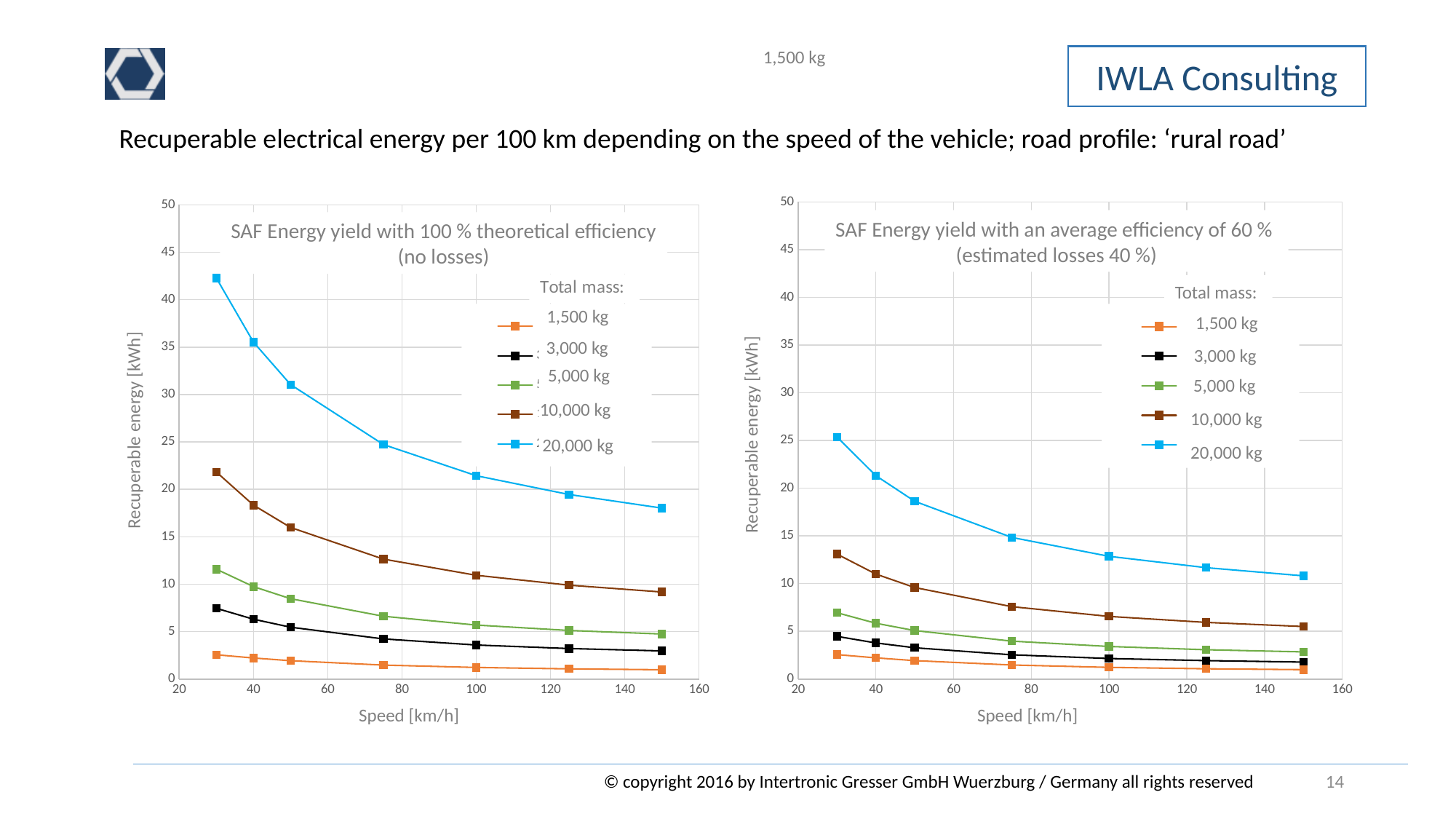
In the left chart (100 % theoretical efficiency), which total mass series has the highest recuperable energy at 30 km/h? 20,000 kg How many series does the legend of the right chart, 'SAF Energy yield with an average efficiency of 60 %', list? 5 How many data points are plotted for each series in the right chart (average efficiency of 60 %)? 7 In the left chart (100 % theoretical efficiency), is the value for 20,000 kg at 30 km/h greater or less than 40? greater In the right chart (average efficiency of 60 %), is the value for 20,000 kg at 30 km/h greater or less than 20? greater In the right chart (average efficiency of 60 %), which total mass series has the lowest recuperable energy across all speeds? 1,500 kg What type of chart is the left chart, 'SAF Energy yield with 100 % theoretical efficiency (no losses)'? line chart In the left chart (100 % theoretical efficiency), does the recuperable energy for the 20,000 kg series rise or fall as speed increases? fall In the left chart (100 % theoretical efficiency), is the value for 20,000 kg at 150 km/h greater or less than 20? less What is the label of the y axis on the left chart (100 % theoretical efficiency)? Recuperable energy [kWh] In the left chart (100 % theoretical efficiency), which is larger at 100 km/h: the value for 10,000 kg or the value for 5,000 kg? 10,000 kg